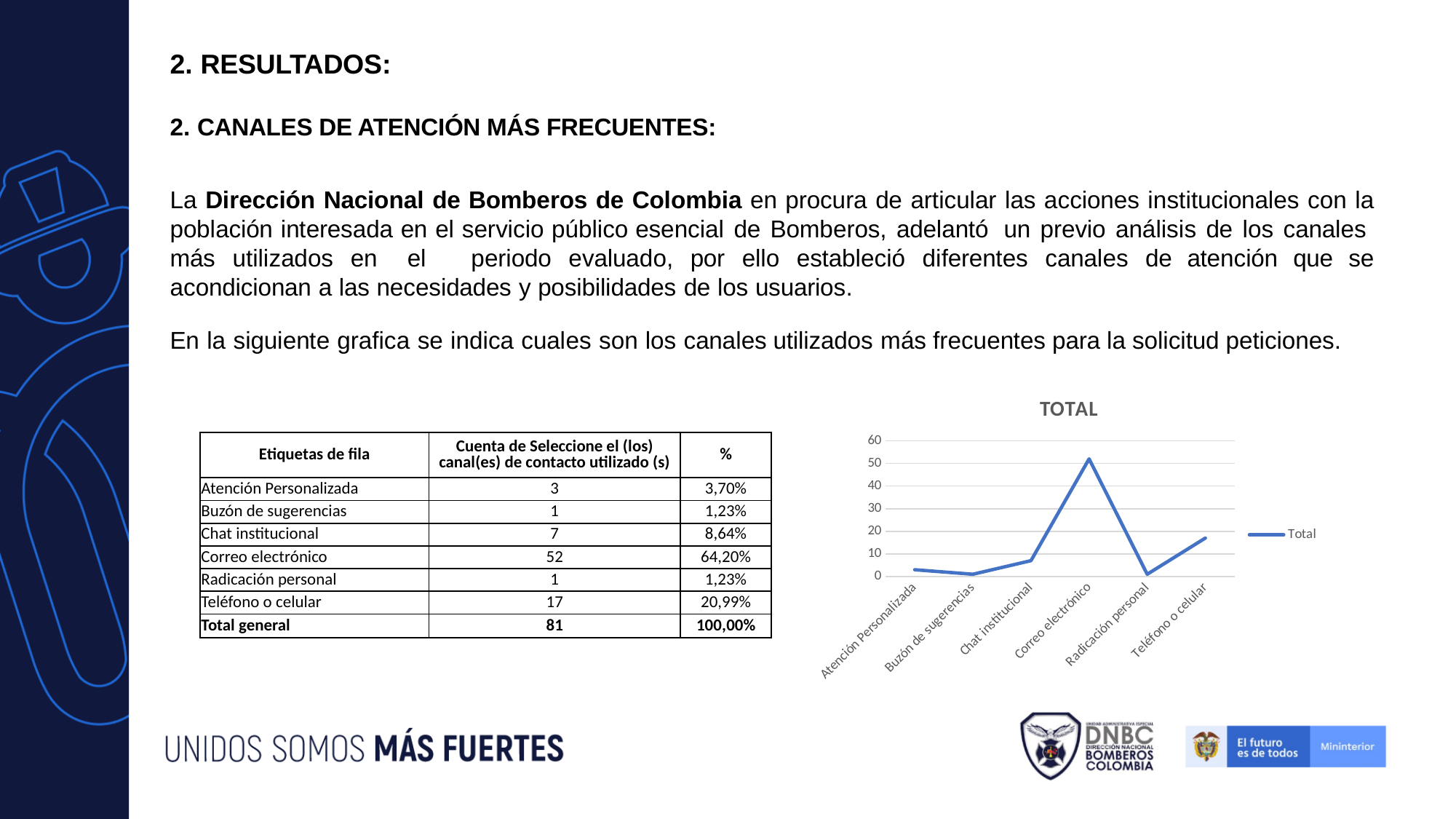
Is the value for Teléfono o celular greater or less than 20? less What kind of chart is shown on the slide? line chart Is the value for Atención Personalizada greater or less than 10? less How many series does the chart legend list? 1 Does the line rise or fall from Correo electrónico to Radicación personal? fall Which category has the highest value in the chart? Correo electrónico Does the line rise or fall from Chat institucional to Correo electrónico? rise Which is larger, the value for Teléfono o celular or the value for Chat institucional? Teléfono o celular Is the value for Chat institucional greater or less than 10? less How many categories are plotted along the x axis of the chart? 6 What is the title of the chart? TOTAL